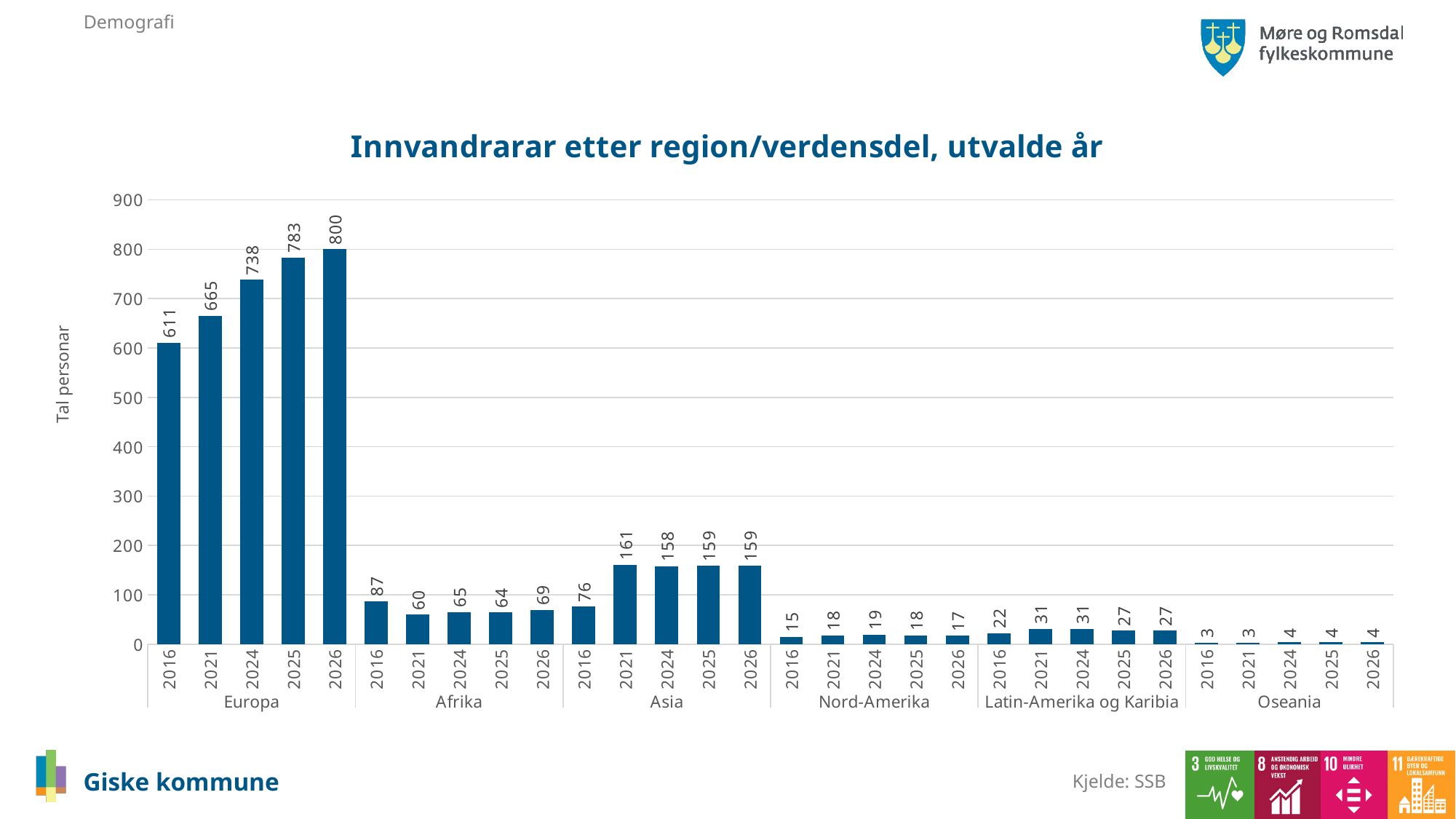
What is the difference between the Europa values for 2026 and 2016? 189 Which region has the lowest value in 2016? Oseania What is the value for Asia in 2021? 161 Is the value for Europa in 2024 greater or less than 700? greater How many regions are shown on the x axis? 6 What is the value for Europa in 2026? 800 What is the value for Latin-Amerika og Karibia in 2025? 27 Which region has the highest value in 2026? Europa Do the Europa values rise or fall from 2016 to 2026? rise What is the value for Afrika in 2016? 87 What kind of chart is this? bar chart Which is larger, the Nord-Amerika value for 2021 or the Latin-Amerika og Karibia value for 2021? Latin-Amerika og Karibia